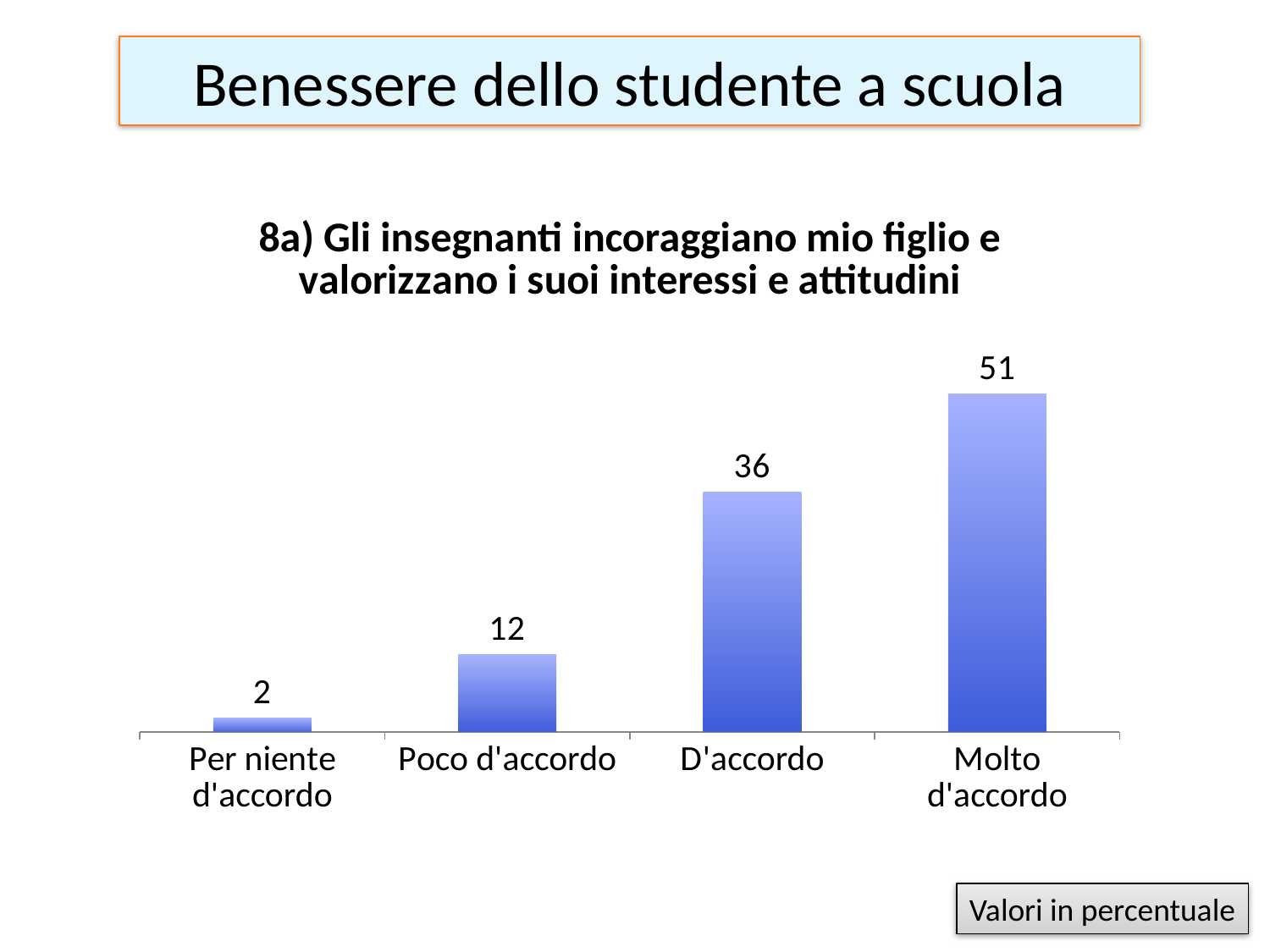
Which category has the lowest value? Per niente d'accordo What is the value for "D'accordo"? 36 What is the value for "Molto d'accordo"? 51 What is the value for "Poco d'accordo"? 12 What is the difference between the values for "Molto d'accordo" and "D'accordo"? 15 How many categories are shown on the x axis? 4 What is the value for "Per niente d'accordo"? 2 Which is larger, the value for "D'accordo" or the value for "Poco d'accordo"? D'accordo What is the difference between the values for "Poco d'accordo" and "Per niente d'accordo"? 10 What kind of chart is shown on the slide? Bar chart Which category has the highest value? Molto d'accordo Do the values rise or fall from left to right along the x axis? Rise